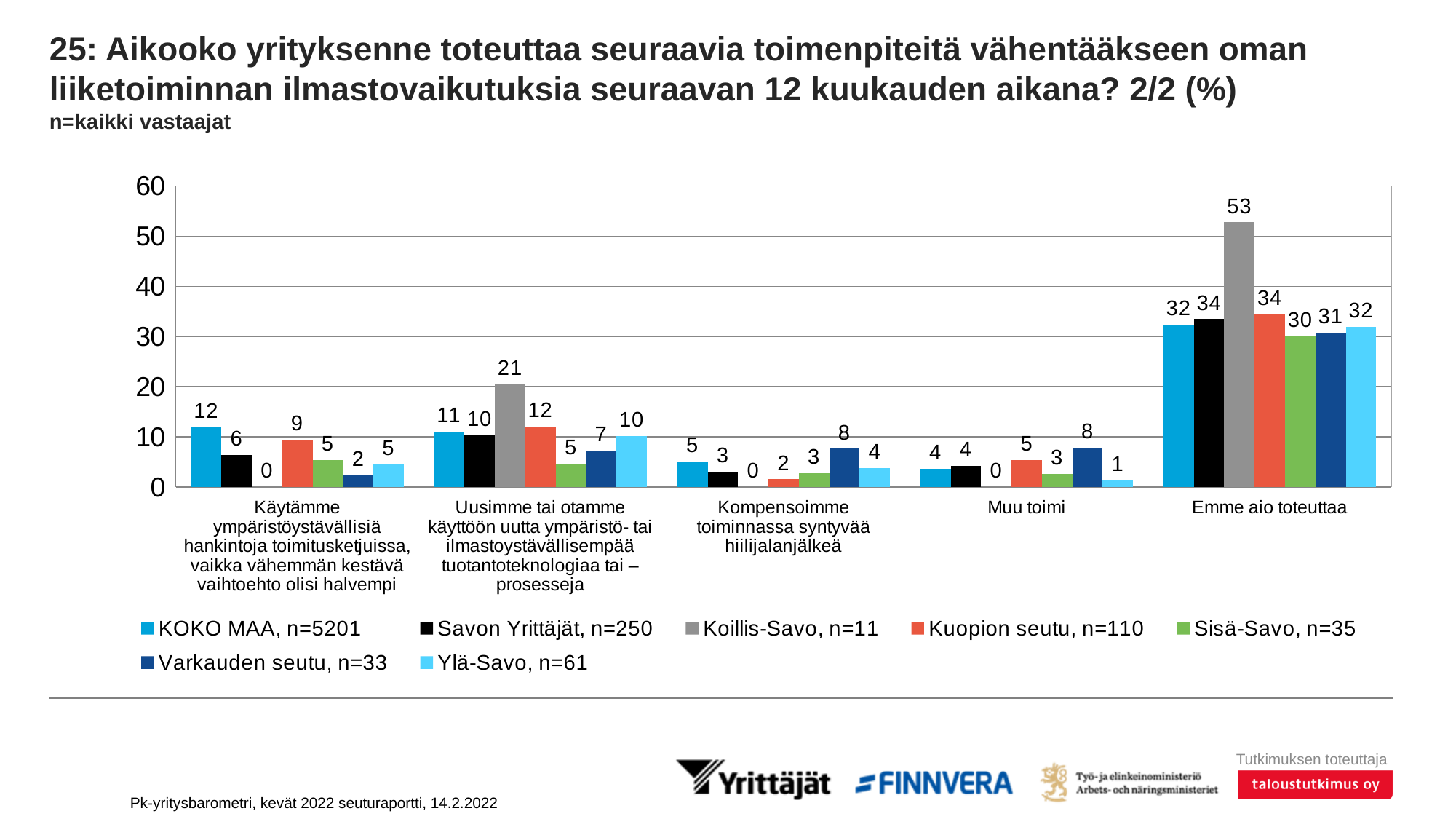
How many series does the legend list? 7 Which series has the lowest value in the "Muu toimi" category? Koillis-Savo, n=11 What is the value for Varkauden seutu, n=33 in the "Kompensoimme toiminnassa syntyvää hiilijalanjälkeä" category? 8 In the "Käytämme ympäristöystävällisiä hankintoja" category, which is larger: the value for Kuopion seutu, n=110 or the value for Savon Yrittäjät, n=250? Kuopion seutu, n=110 What kind of chart is shown on the slide? bar chart What is the difference between the Koillis-Savo, n=11 value and the Sisä-Savo, n=35 value in the "Emme aio toteuttaa" category? 23 How many categories are shown on the x axis of the chart? 5 Is the value for Koillis-Savo, n=11 in the "Emme aio toteuttaa" category greater or less than 50? greater Which series has the highest value in the "Uusimme tai otamme käyttöön uutta ympäristö- tai ilmastoystävällisempää tuotantoteknologiaa tai –prosesseja" category? Koillis-Savo, n=11 What is the value for KOKO MAA, n=5201 in the "Käytämme ympäristöystävällisiä hankintoja toimitusketjuissa, vaikka vähemmän kestävä vaihtoehto olisi halvempi" category? 12 What is the value for Ylä-Savo, n=61 in the "Muu toimi" category? 1 What is the value for Koillis-Savo, n=11 in the "Emme aio toteuttaa" category? 53